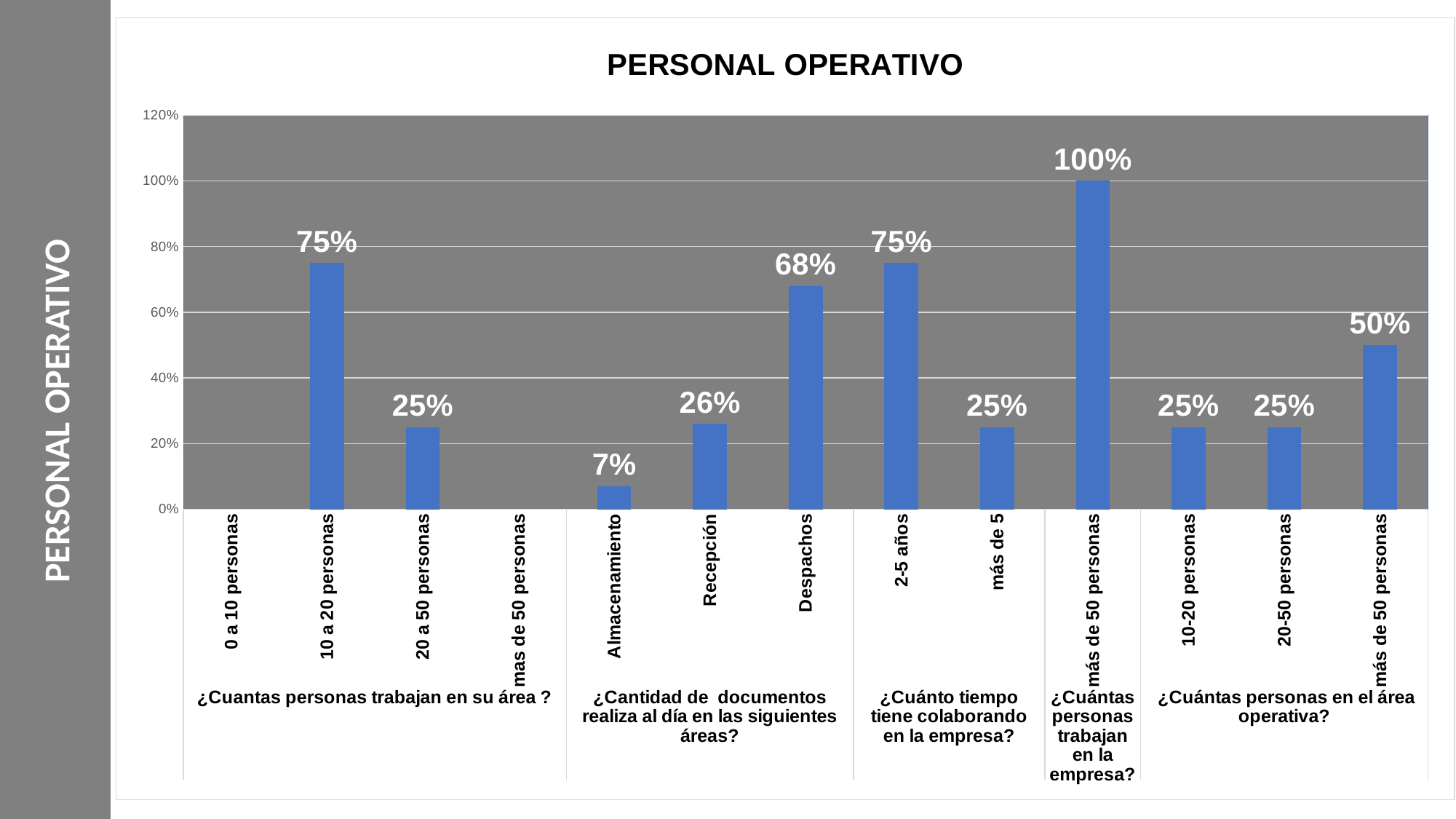
Which category has the lowest labelled value in the chart? Almacenamiento What is the title of the chart? PERSONAL OPERATIVO Which category has the highest value in the chart? más de 50 personas (¿Cuántas personas trabajan en la empresa?) Which is larger, the value for '2-5 años' or the value for 'más de 5'? 2-5 años What is the value for 'Despachos'? 68% What type of chart is shown on the slide? bar chart What is the value for '10 a 20 personas' under '¿Cuantas personas trabajan en su área ?'? 75% Is the value for 'Recepción' greater or less than 40%? less What is the value for 'más de 50 personas' under '¿Cuántas personas trabajan en la empresa?'? 100% What is the value for 'Almacenamiento'? 7% What is the difference between the values for 'Despachos' and 'Recepción'? 42% What is the value for 'más de 50 personas' under '¿Cuántas personas en el área operativa?'? 50%